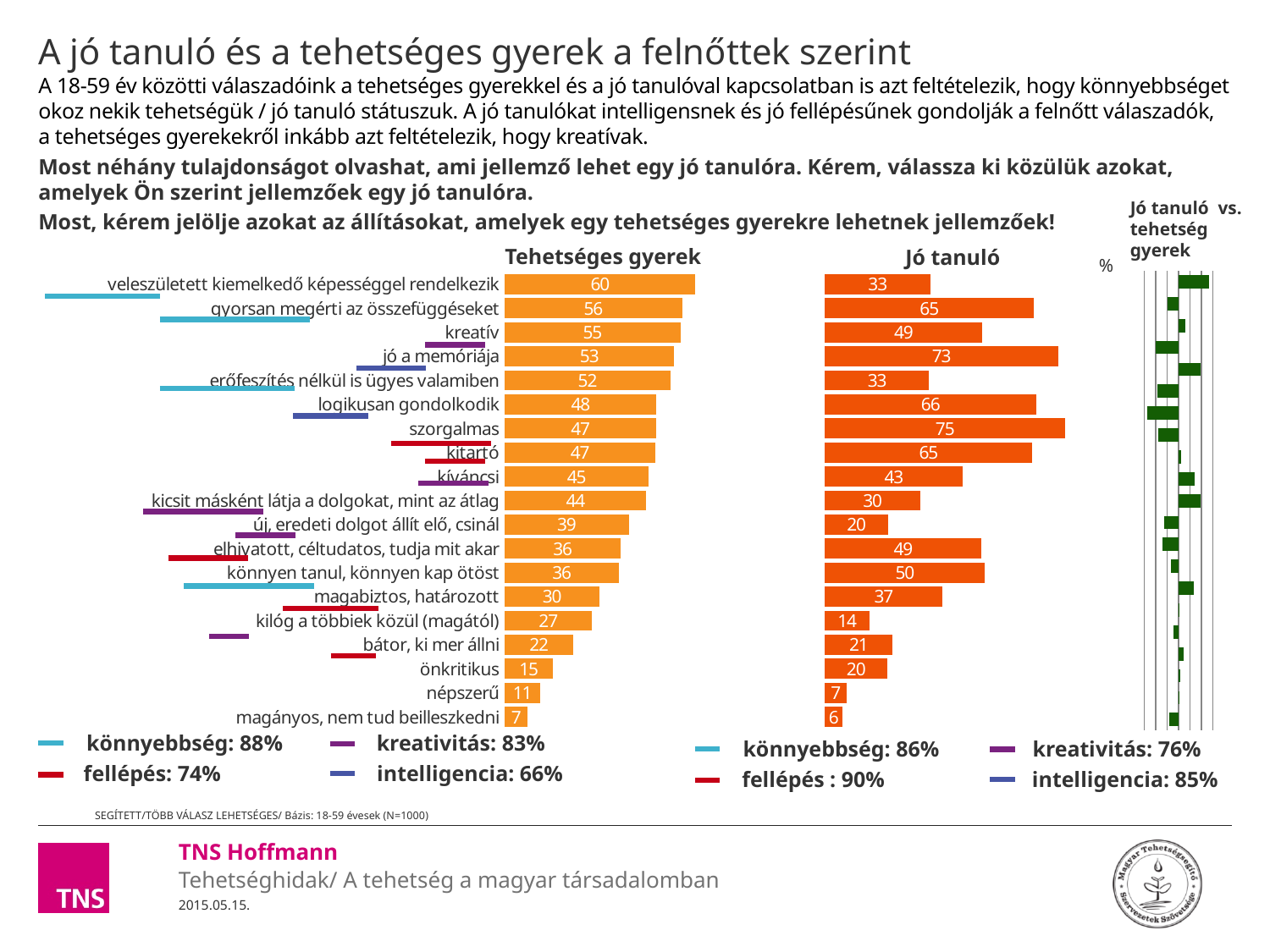
In the "Jó tanuló" chart, which category has the highest value? szorgalmas In the "Tehetséges gyerek" chart, what is the difference between "veleszületett kiemelkedő képességgel rendelkezik" and "magányos, nem tud beilleszkedni"? 53 How many categories are listed in the "Tehetséges gyerek" chart? 19 In the "Jó tanuló" chart, which category has the lowest value? magányos, nem tud beilleszkedni For "jó a memóriája", which chart shows the larger value, "Tehetséges gyerek" or "Jó tanuló"? Jó tanuló What kind of chart is the "Jó tanuló" chart? bar chart In the "Jó tanuló" chart, what is the value for "szorgalmas"? 75 In the "Tehetséges gyerek" chart, which category has the highest value? veleszületett kiemelkedő képességgel rendelkezik In the "Tehetséges gyerek" chart, what is the value for "kreatív"? 55 In the "Jó tanuló" chart, what is the value for "népszerű"? 7 In the "Tehetséges gyerek" chart, what is the difference between "kreatív" and "önkritikus"? 40 For "kicsit másként látja a dolgokat, mint az átlag", which chart shows the larger value, "Tehetséges gyerek" or "Jó tanuló"? Tehetséges gyerek